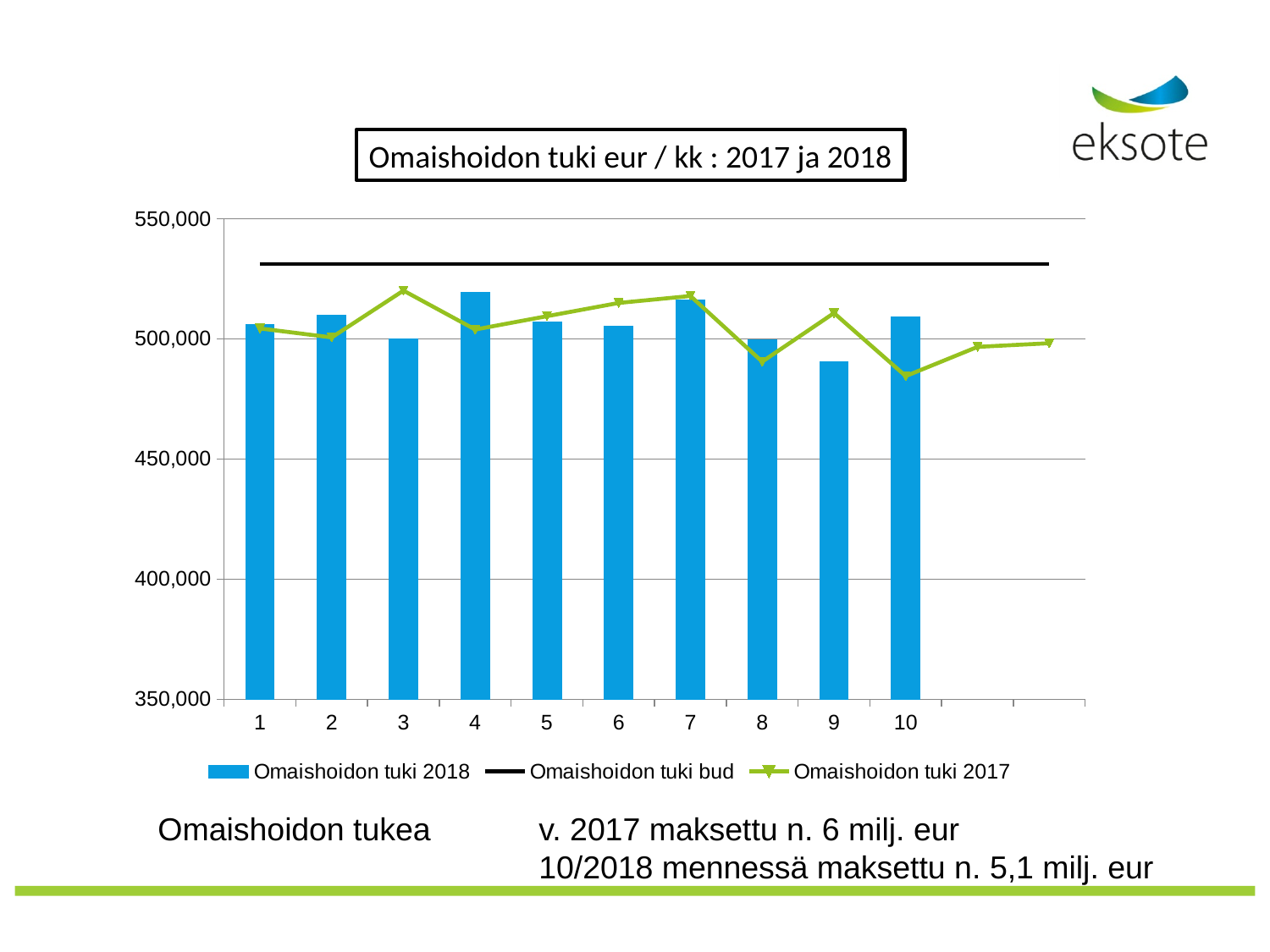
Which is larger: the Omaishoidon tuki 2018 bar for month 4 or for month 9? Month 4 How many series does the legend list? 3 Is the Omaishoidon tuki 2017 value for month 10 greater or less than 500,000? less Is the Omaishoidon tuki 2018 bar for month 9 greater or less than 500,000? less What is the title of the chart? Omaishoidon tuki eur / kk : 2017 ja 2018 Is the Omaishoidon tuki bud line greater or less than 500,000? greater How many bars are plotted for the series Omaishoidon tuki 2018? 10 What kind of chart is shown on the slide? A combined bar and line chart Which month has the lowest bar for Omaishoidon tuki 2018? 9 What colour are the Omaishoidon tuki 2018 bars? Blue Which is larger for month 3: the Omaishoidon tuki 2018 bar or the Omaishoidon tuki 2017 line value? Omaishoidon tuki 2017